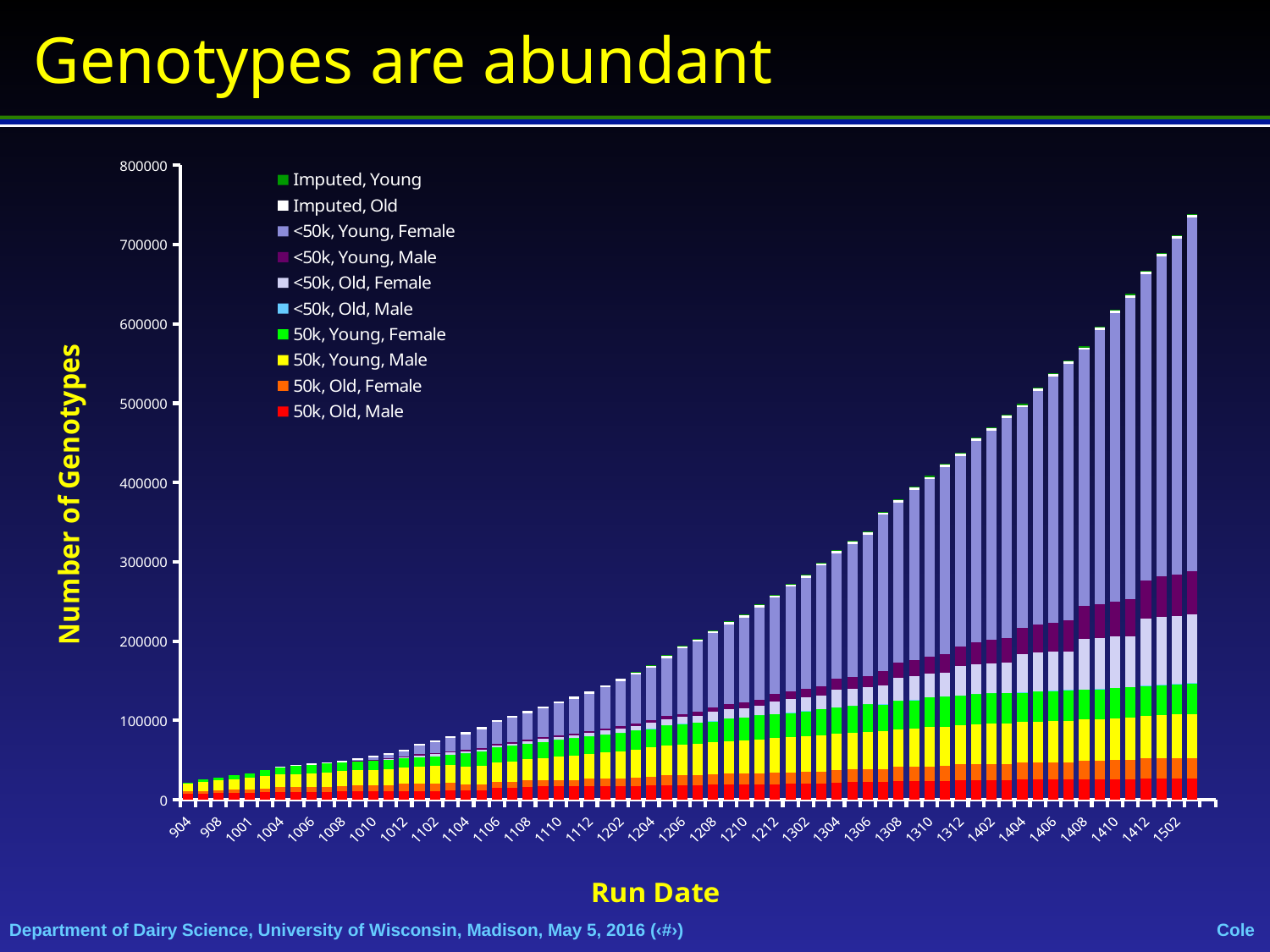
Which run date has a larger total number of genotypes, 1302 or 1410? 1410 Do the total number of genotypes rise or fall as the run date moves from 904 to 1502? rise What is the title of the x axis? Run Date What kind of chart is shown on the slide? stacked bar chart Is the total number of genotypes for run date 1210 greater or less than 200000? greater Is the total number of genotypes for run date 1502 greater or less than 700000? greater Which run date has the lowest total number of genotypes? 904 What is the title of the y axis? Number of Genotypes How many series does the legend list? 10 Is the total number of genotypes for run date 904 greater or less than 100000? less